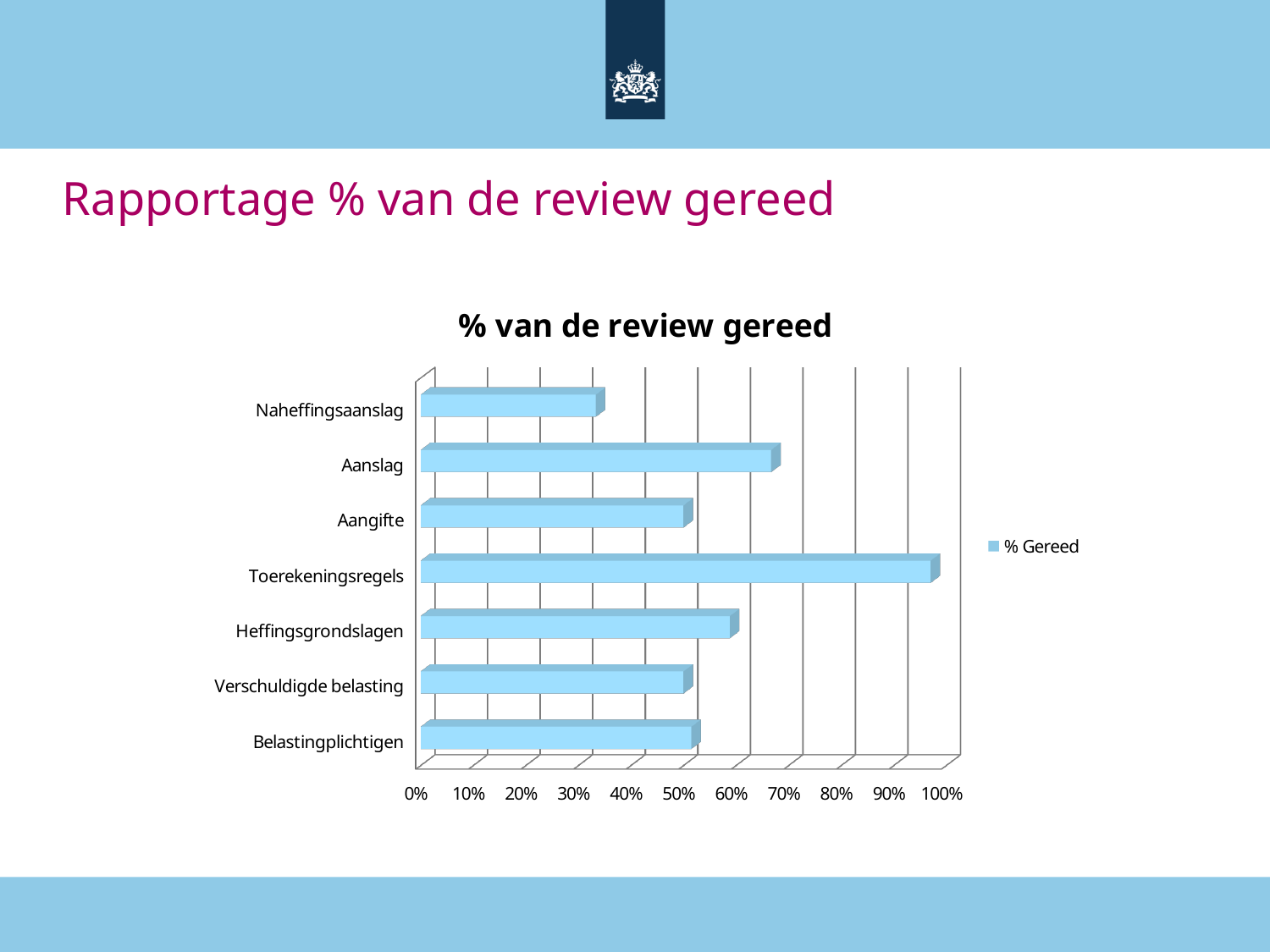
How many categories are plotted in the chart? 7 Which category has the lowest value? Naheffingsaanslag Is the value for Toerekeningsregels greater or less than 90%? greater How many series does the legend list? 1 Is the value for Naheffingsaanslag greater or less than 40%? less What is the name of the series shown in the legend? % Gereed What is the title of the chart? % van de review gereed What kind of chart is shown on the slide? Bar chart Which category has the highest value? Toerekeningsregels Which is larger, the value for Aanslag or the value for Heffingsgrondslagen? Aanslag Is the value for Heffingsgrondslagen greater or less than 50%? greater